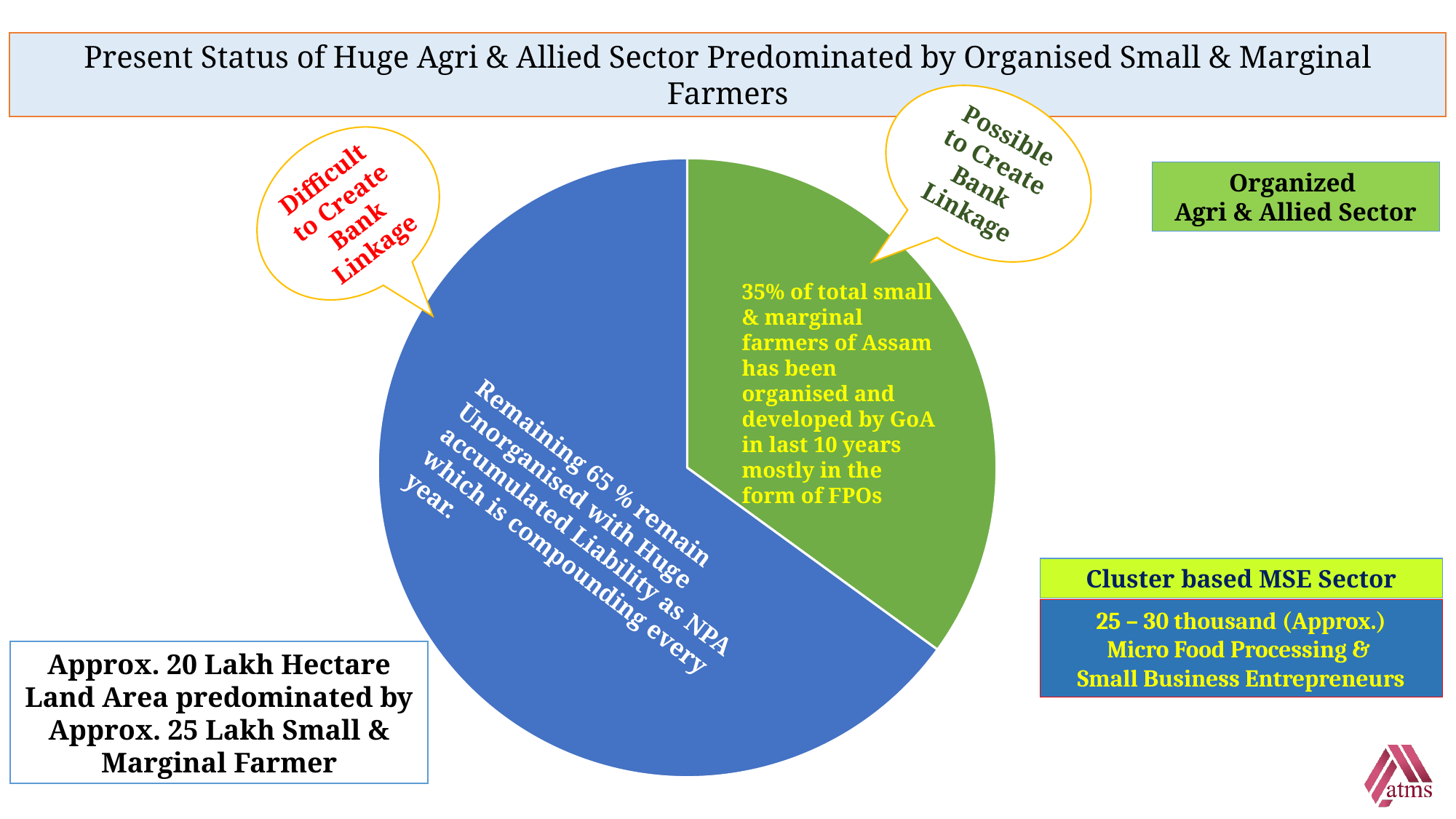
What kind of chart is shown on the slide? pie chart Which slice of the pie chart is the largest? 65% unorganised (blue) How many slices does the pie chart have? 2 Which slice of the pie chart is larger, the organised (green) slice or the unorganised (blue) slice? unorganised (blue) What share of small & marginal farmers remain unorganised, according to the blue slice? 65 % Which slice of the pie chart is the smallest? 35% organised (green) What share of small & marginal farmers of Assam has been organised and developed by GoA, according to the green slice? 35% What does the callout pointing to the green slice say? Possible to Create Bank Linkage What colour is the slice representing the 35% of organised farmers? green Is the share of the organised (green) slice greater or less than 50%? less What is the difference in percentage points between the unorganised slice and the organised slice? 30